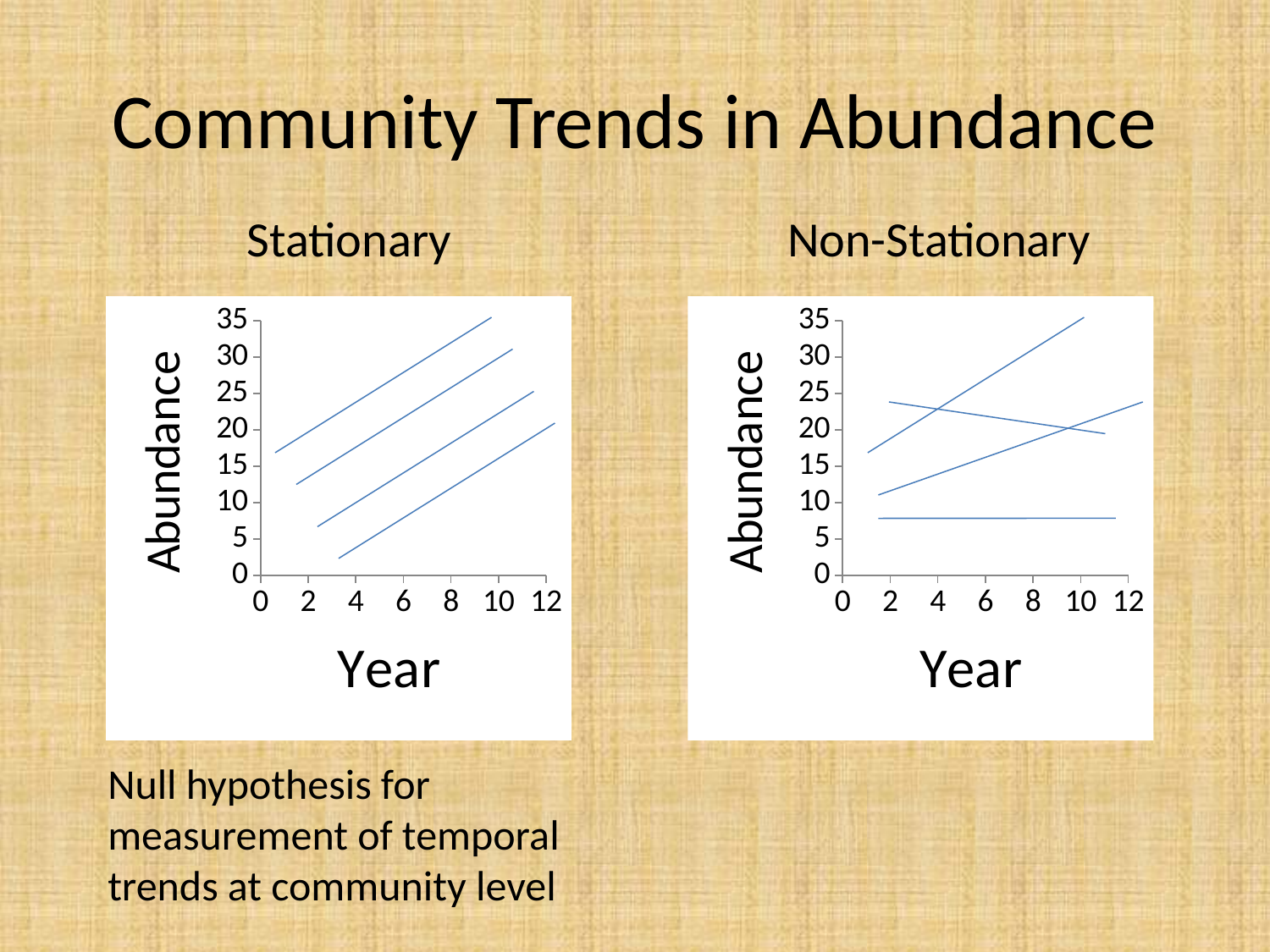
How many lines are plotted in the Non-Stationary chart? 4 What is the maximum value shown on the x axis of the Stationary chart? 12 What kind of chart is the Stationary chart? Line chart What is the label on the x axis of the Non-Stationary chart? Year In the Stationary chart, is the highest point reached by any line greater or less than 30? greater What is the maximum value shown on the y axis of the Non-Stationary chart? 35 What kind of chart is the Non-Stationary chart? Line chart In the Stationary chart, do the lines rise or fall as Year increases? Rise In the Non-Stationary chart, do all the lines rise as Year increases? No How many lines are plotted in the Stationary chart? 4 In the Non-Stationary chart, is the value of the flat horizontal line greater or less than 10? less What is the label on the y axis of the Stationary chart? Abundance